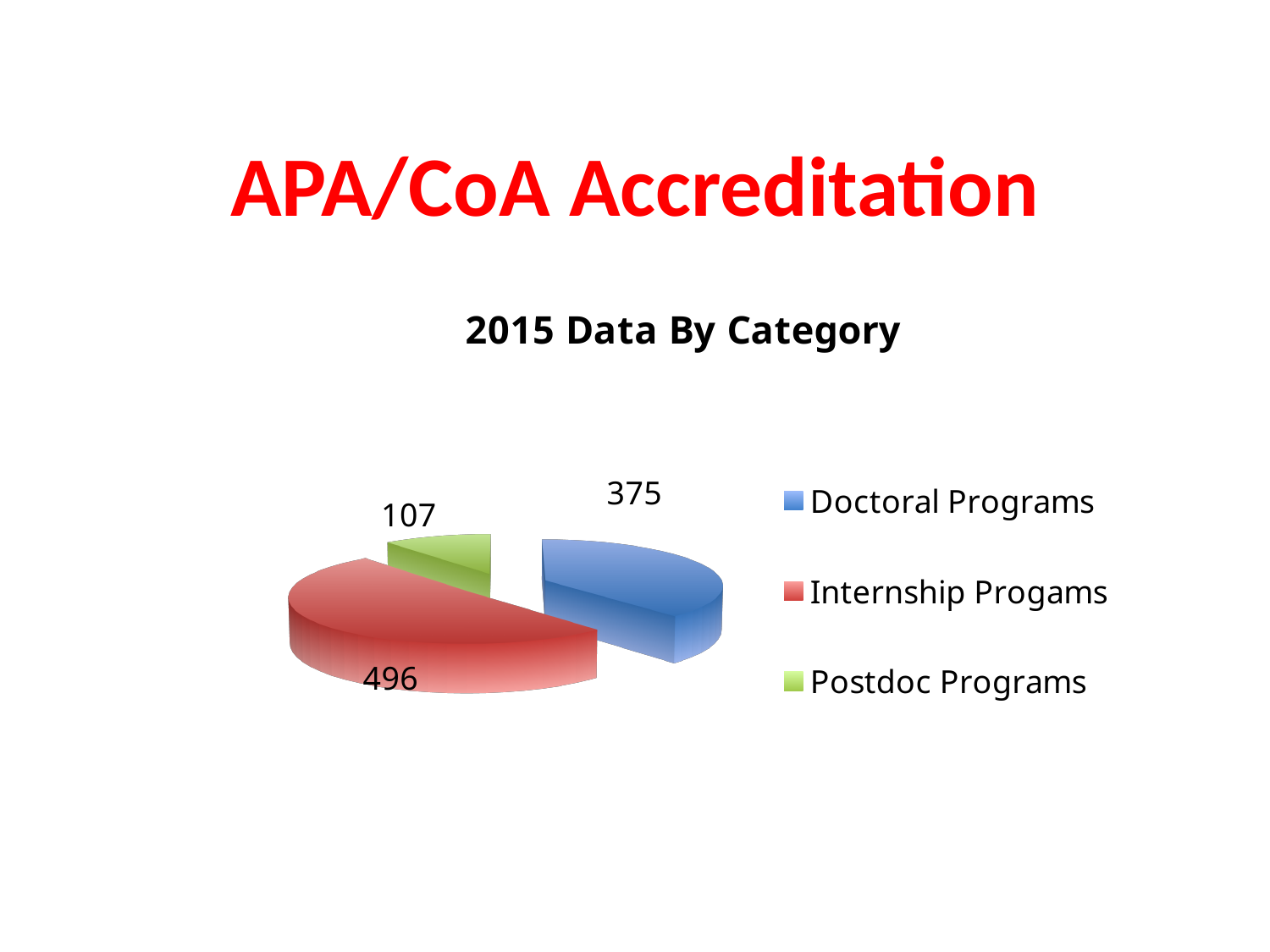
What is the title of the chart? 2015 Data By Category Which category has the largest slice? Internship Progams What colour is the Postdoc Programs slice? Green What is the value for Postdoc Programs? 107 How many categories does the pie chart show? 3 What kind of chart is shown on the slide? Pie chart Which category has the smallest slice? Postdoc Programs What is the difference between the Doctoral Programs value and the Postdoc Programs value? 268 What is the difference between the Internship Progams value and the Doctoral Programs value? 121 What is the value for Internship Progams? 496 What is the value for Doctoral Programs? 375 Which is larger, Doctoral Programs or Postdoc Programs? Doctoral Programs